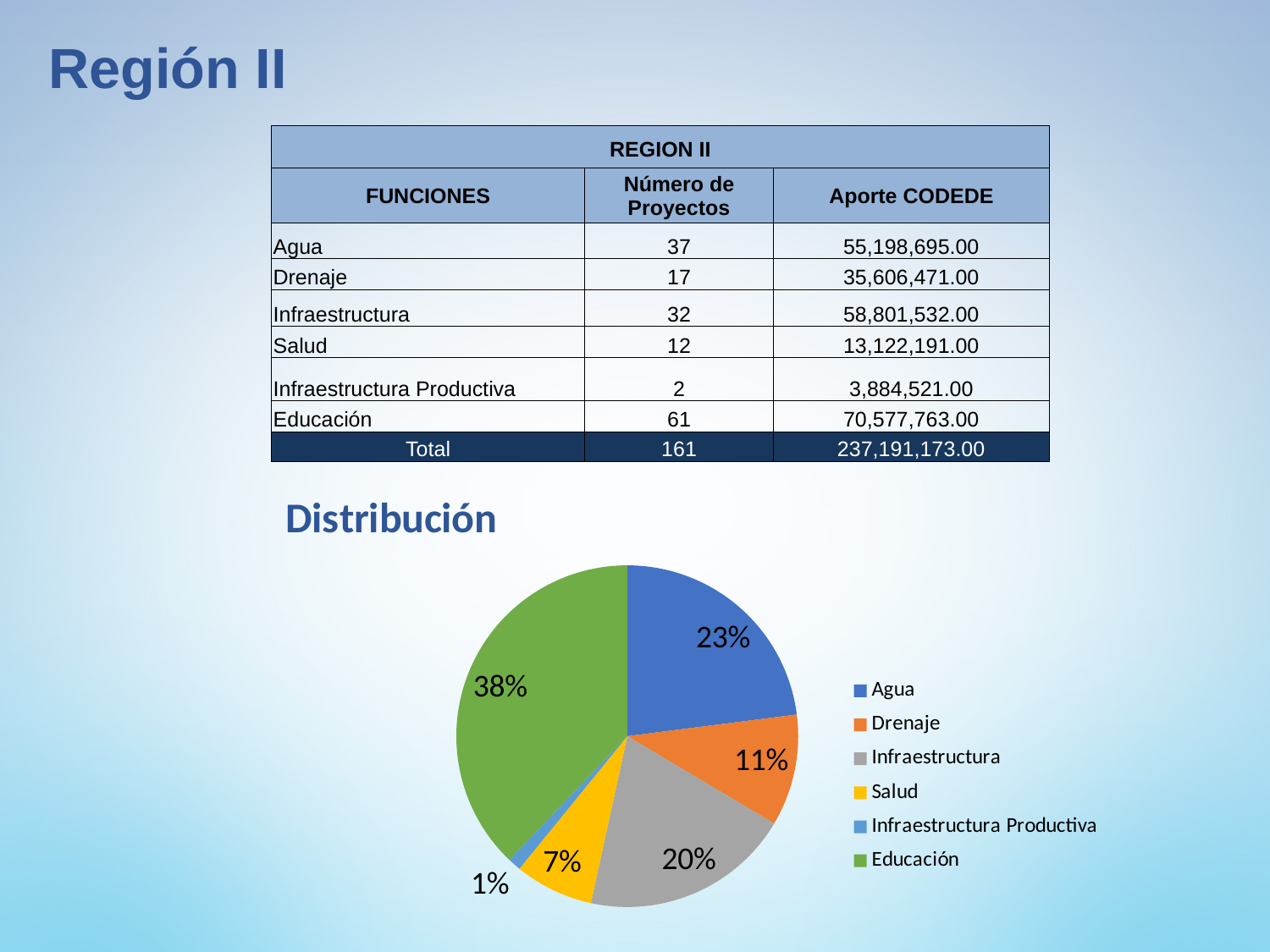
How many categories does the Distribución pie chart show? 6 What share of the Distribución pie chart does Infraestructura Productiva represent? 1% Which category has the largest slice in the Distribución pie chart? Educación In the Distribución pie chart, which is larger, the Drenaje slice or the Infraestructura slice? Infraestructura What share of the Distribución pie chart does Salud represent? 7% Which category has the smallest slice in the Distribución pie chart? Infraestructura Productiva What kind of chart is shown under the heading Distribución? Pie chart In the Distribución pie chart, what is the difference in percentage points between Educación and Agua? 15 What colour is the Educación slice in the Distribución pie chart? Green What share of the Distribución pie chart does Infraestructura represent? 20%